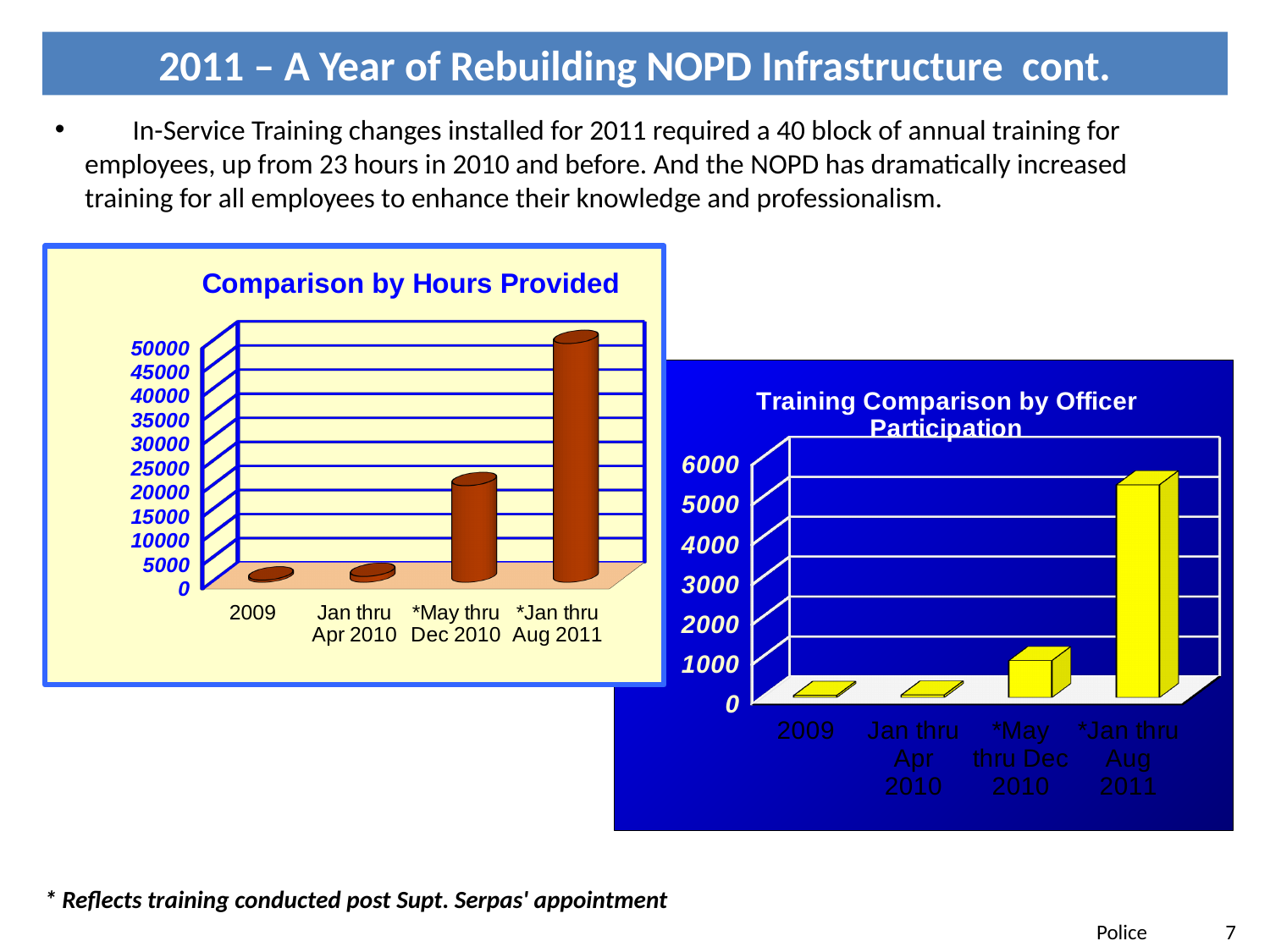
In the 'Comparison by Hours Provided' chart, is the value for *Jan thru Aug 2011 greater or less than 45000? greater What kind of chart is the 'Training Comparison by Officer Participation' chart? bar chart What kind of chart is the 'Comparison by Hours Provided' chart? bar chart In the 'Training Comparison by Officer Participation' chart, which is larger, the value for *May thru Dec 2010 or the value for *Jan thru Aug 2011? *Jan thru Aug 2011 In the 'Comparison by Hours Provided' chart, which category has the lowest value? 2009 In the 'Training Comparison by Officer Participation' chart, is the value for *Jan thru Aug 2011 greater or less than 5000? greater In the 'Comparison by Hours Provided' chart, do the values rise or fall from left to right along the x axis? rise In the 'Training Comparison by Officer Participation' chart, which category has the highest value? *Jan thru Aug 2011 What colour are the bars in the 'Training Comparison by Officer Participation' chart? yellow In the 'Comparison by Hours Provided' chart, is the value for *May thru Dec 2010 greater or less than 25000? less How many categories are shown on the x axis of the 'Comparison by Hours Provided' chart? 4 In the 'Comparison by Hours Provided' chart, which category has the highest value? *Jan thru Aug 2011